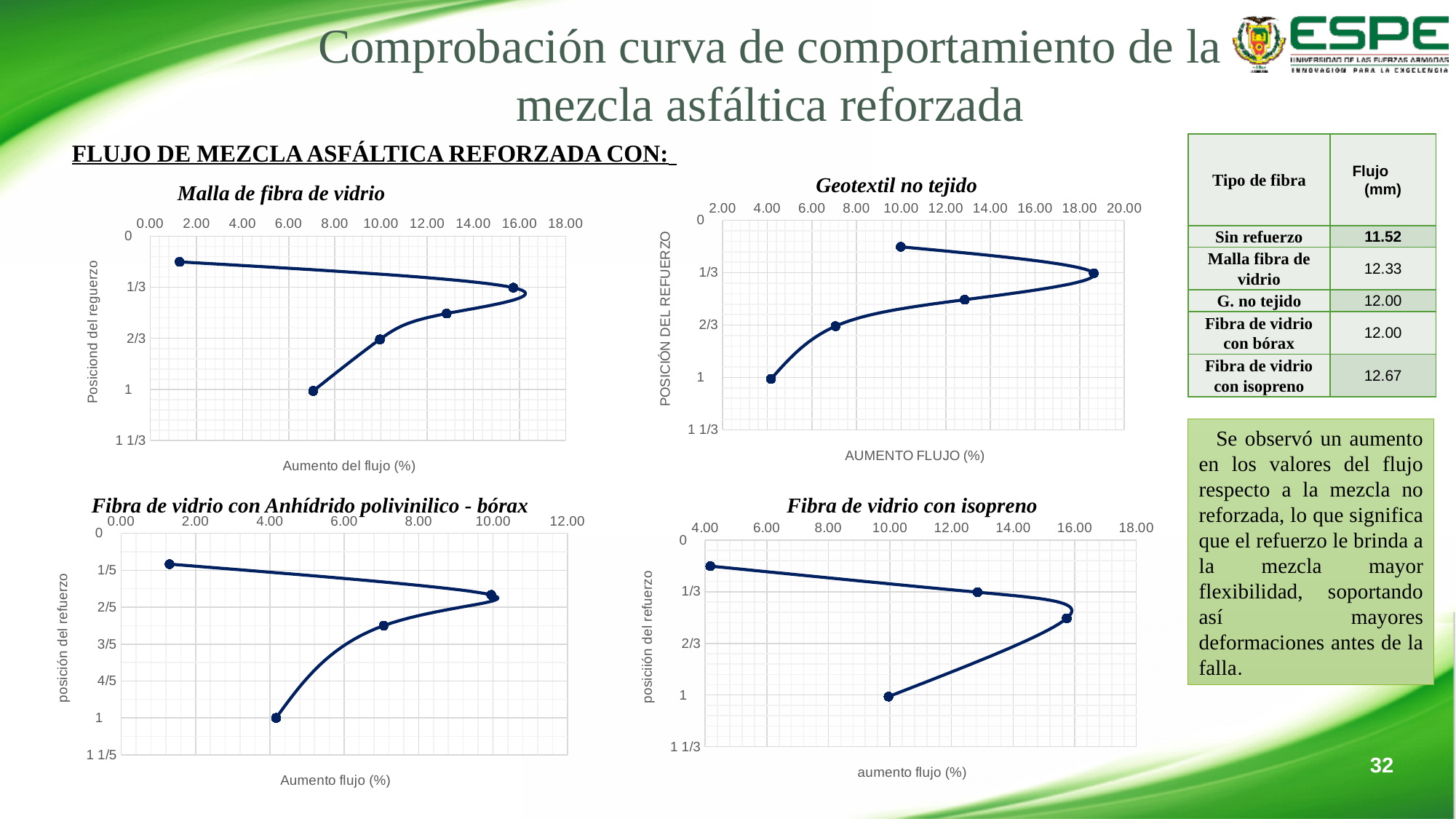
On the 'Malla de fibra de vidrio' chart, is the flow increase at reinforcement position 1 greater or less than 10.00? less How many data points are plotted on the 'Fibra de vidrio con Anhídrido polivinilico - bórax' chart? 4 On the 'Geotextil no tejido' chart, is the flow increase at reinforcement position 1 greater or less than 6.00? less How many data points are plotted on the 'Malla de fibra de vidrio' chart? 5 What is the x-axis label of the 'Geotextil no tejido' chart? AUMENTO FLUJO (%) On the 'Geotextil no tejido' chart, is the flow increase at reinforcement position 1/3 greater or less than 16.00? greater How many data points are plotted on the 'Geotextil no tejido' chart? 5 What kind of chart is the 'Malla de fibra de vidrio' chart? line chart